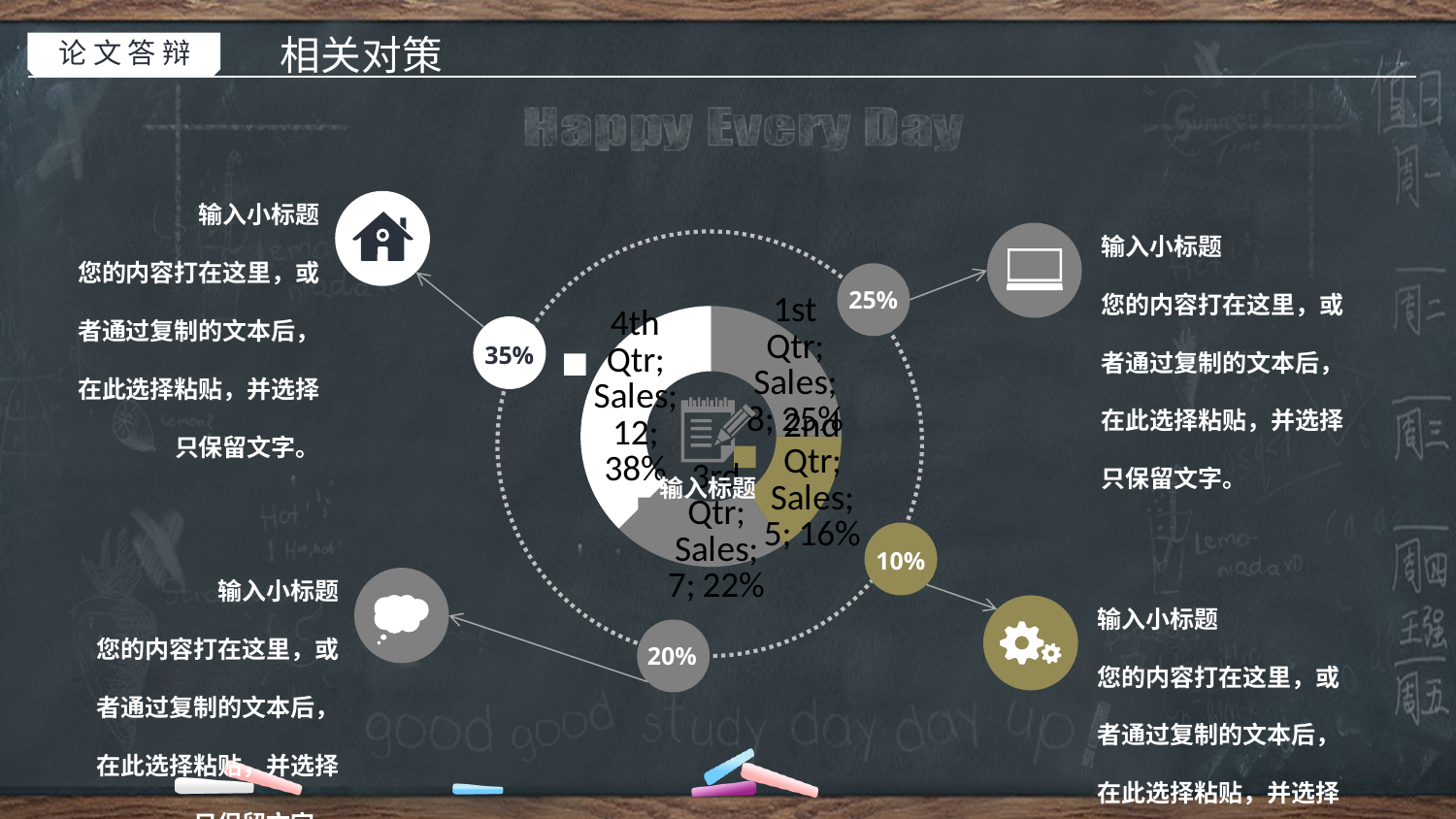
How many quarters (categories) are shown in the doughnut chart? 4 What percentage share does 3rd Qtr have in the doughnut chart? 22% What is the name of the data series plotted in the doughnut chart? Sales What is the Sales value for 4th Qtr in the doughnut chart? 12 What percentage share does 1st Qtr have in the doughnut chart? 25% Which quarter has the smallest Sales value in the doughnut chart? 2nd Qtr What is the total of the Sales values across all four quarters in the doughnut chart? 32 What is the Sales value for 2nd Qtr in the doughnut chart? 5 Which has a larger Sales value in the doughnut chart, 1st Qtr or 3rd Qtr? 1st Qtr Which quarter has the largest Sales value in the doughnut chart? 4th Qtr What kind of chart is shown in the centre of the slide? doughnut chart What is the difference between the Sales values for 4th Qtr and 1st Qtr in the doughnut chart? 4